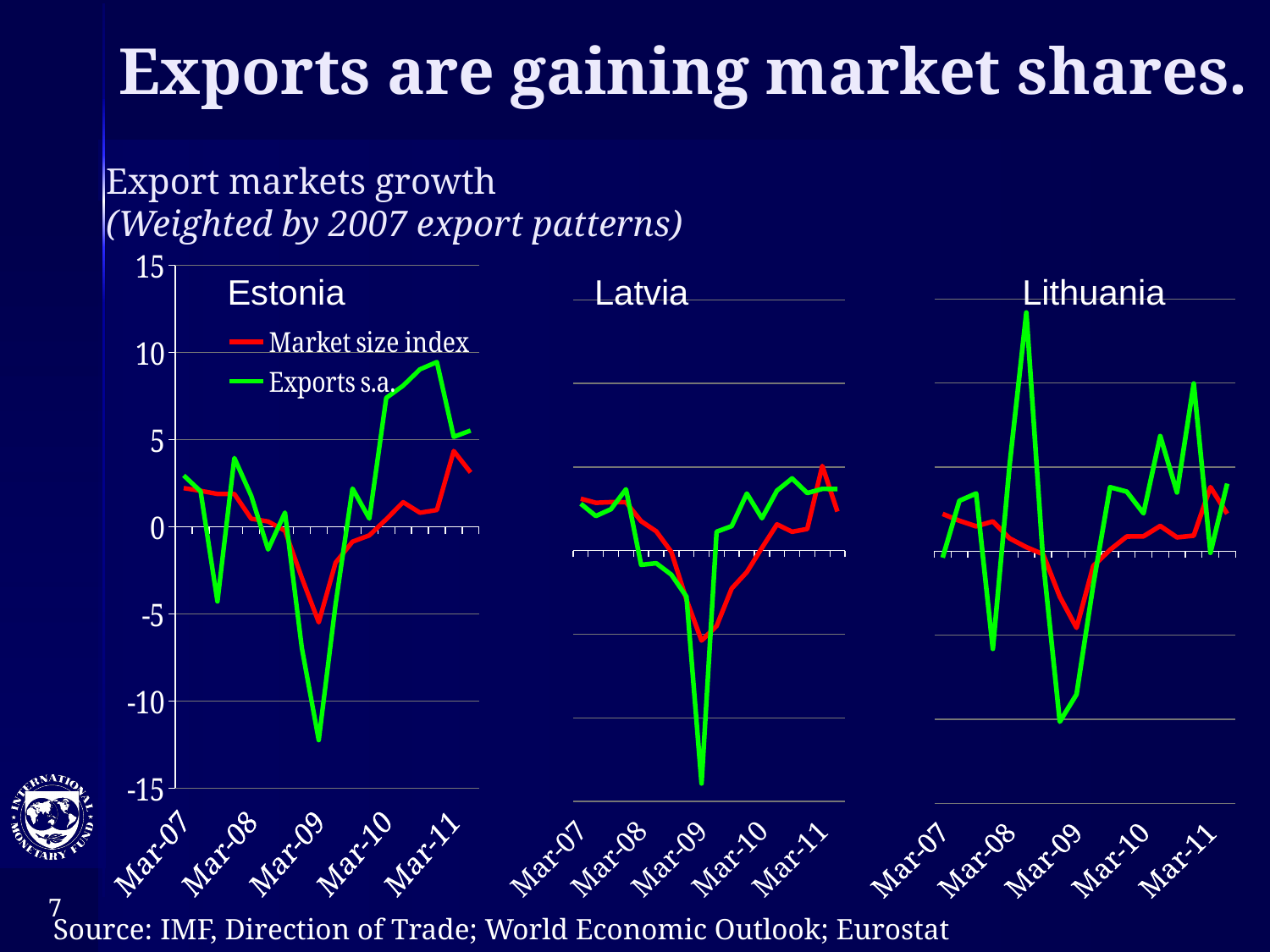
What are the two series named in the legend of the Estonia chart? Market size index and Exports s.a. In the Estonia chart, which series reaches the lower value around Mar-09, Market size index or Exports s.a.? Exports s.a. How many country charts are shown on the slide? 3 How many series does the legend on the Estonia chart list? 2 What kind of chart is used for the Estonia panel? line chart In the Estonia chart, is the lowest value of Exports s.a. greater or less than -10? less In the Estonia chart, is the Market size index value at Mar-07 greater or less than 0? greater In the Estonia chart, is the highest value of Exports s.a. greater or less than 5? greater Across the three charts, which country shows the deepest trough in Exports s.a.? Latvia In the Latvia chart, which series has the deepest trough? Exports s.a. In the Estonia chart, does Exports s.a. rise or fall between Mar-09 and Mar-10? rise Which colour is used for the Exports s.a. series? green